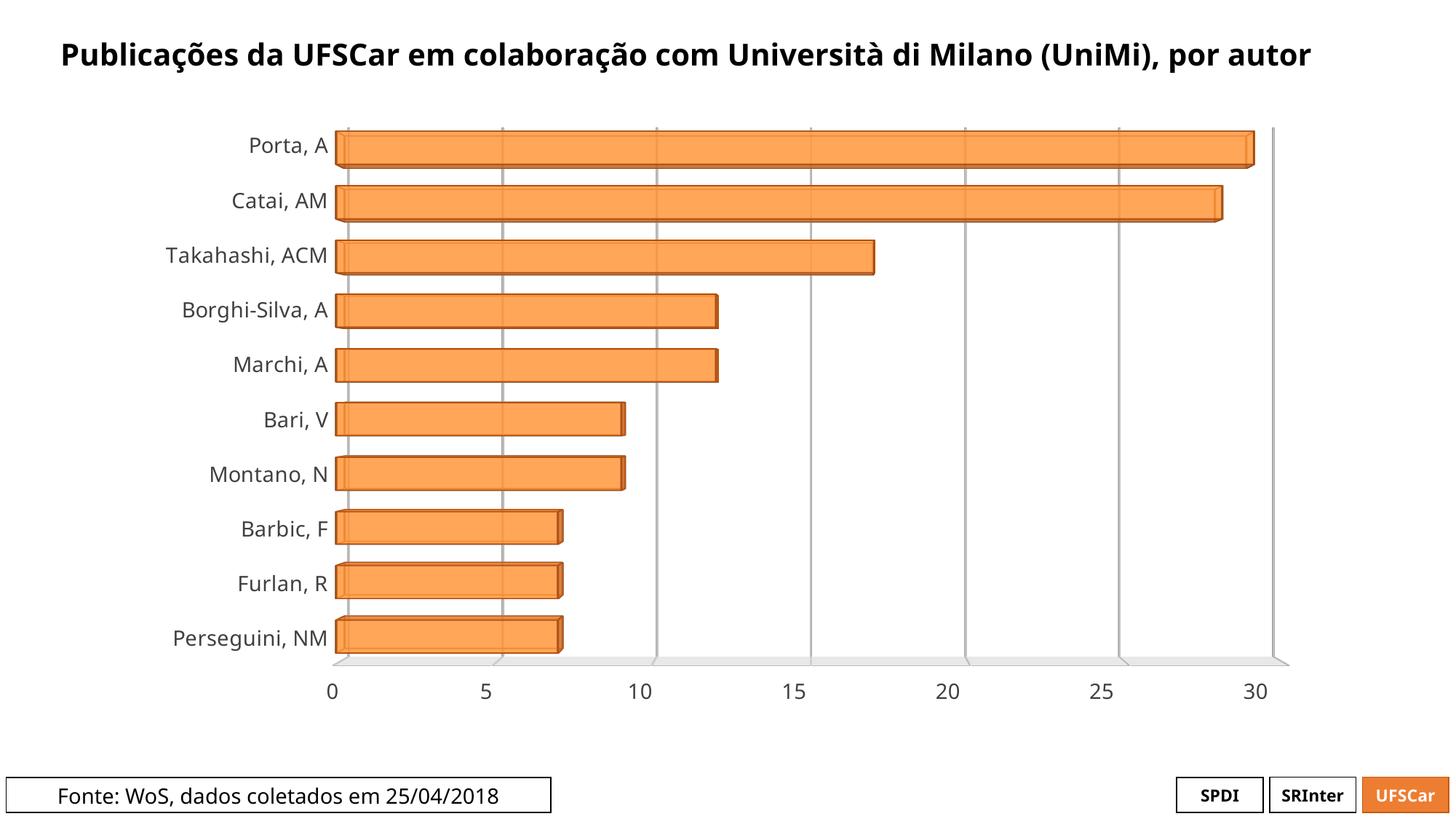
Is the value for Takahashi, ACM greater or less than 15? greater Is the value for Bari, V greater or less than 10? less What is the title of the chart? Publicações da UFSCar em colaboração com Università di Milano (UniMi), por autor Is the value for Borghi-Silva, A greater or less than 10? greater Which is larger, the value for Takahashi, ACM or the value for Borghi-Silva, A? Takahashi, ACM How many authors are listed on the chart? 10 What kind of chart is shown on the slide? bar chart Which author has the highest number of publications? Porta, A Which is larger, the value for Marchi, A or the value for Montano, N? Marchi, A What is the data source cited at the bottom of the slide? WoS, dados coletados em 25/04/2018